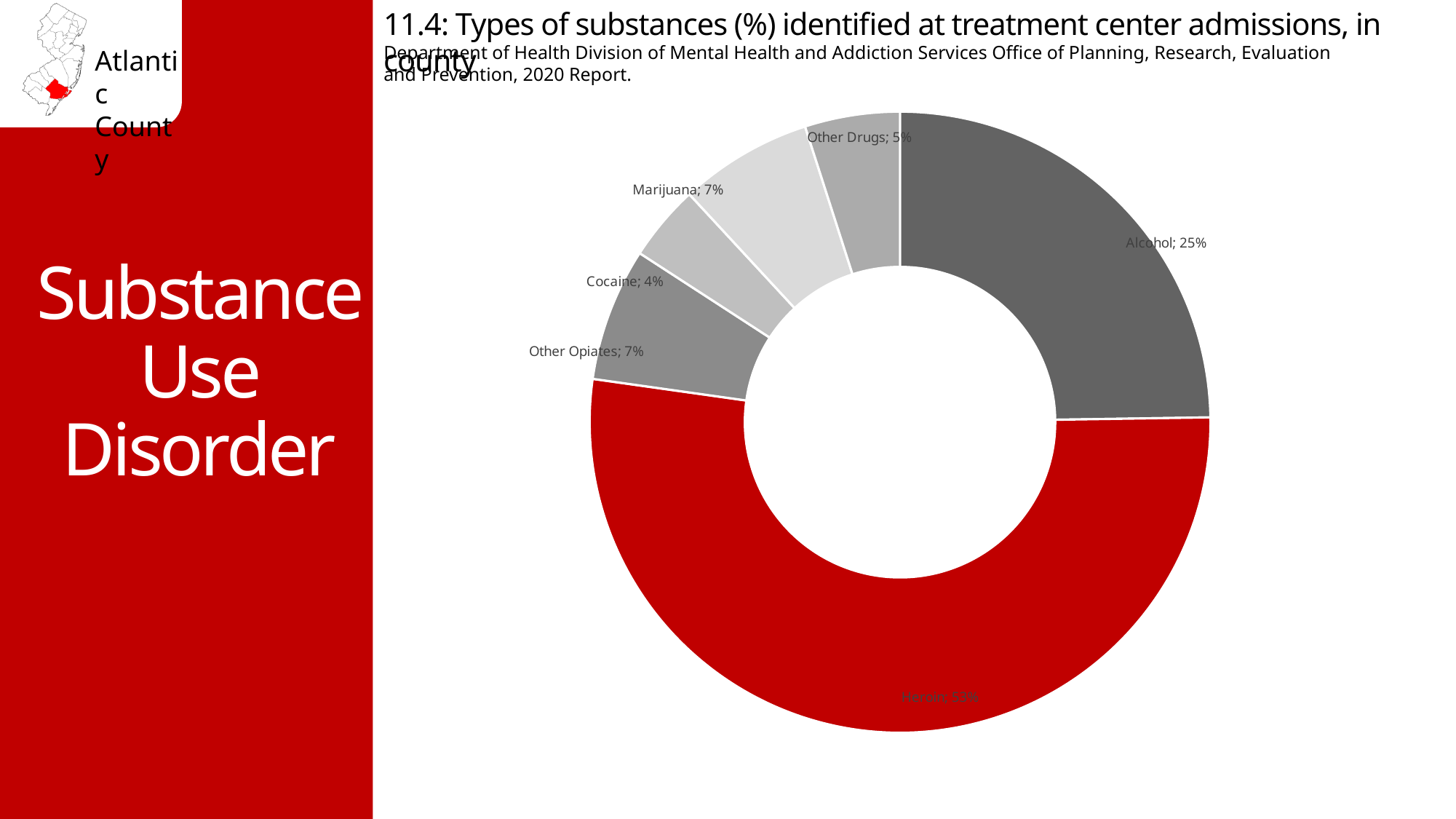
How many substance categories are shown in the chart? 6 What percentage is shown for Cocaine? 4% Which has a larger share, Alcohol or Other Drugs? Alcohol Which substance accounts for the largest share of admissions? Heroin What percentage of treatment center admissions identified Alcohol? 25% What percentage is shown for Other Opiates? 7% What kind of chart is shown on the slide? Doughnut (pie) chart How many percentage points higher is Alcohol than Cocaine? 21 percentage points Which substance accounts for the smallest share of admissions? Cocaine What percentage is shown for Marijuana? 7% What percentage is shown for Other Drugs? 5% What colour is the Heroin slice? Red